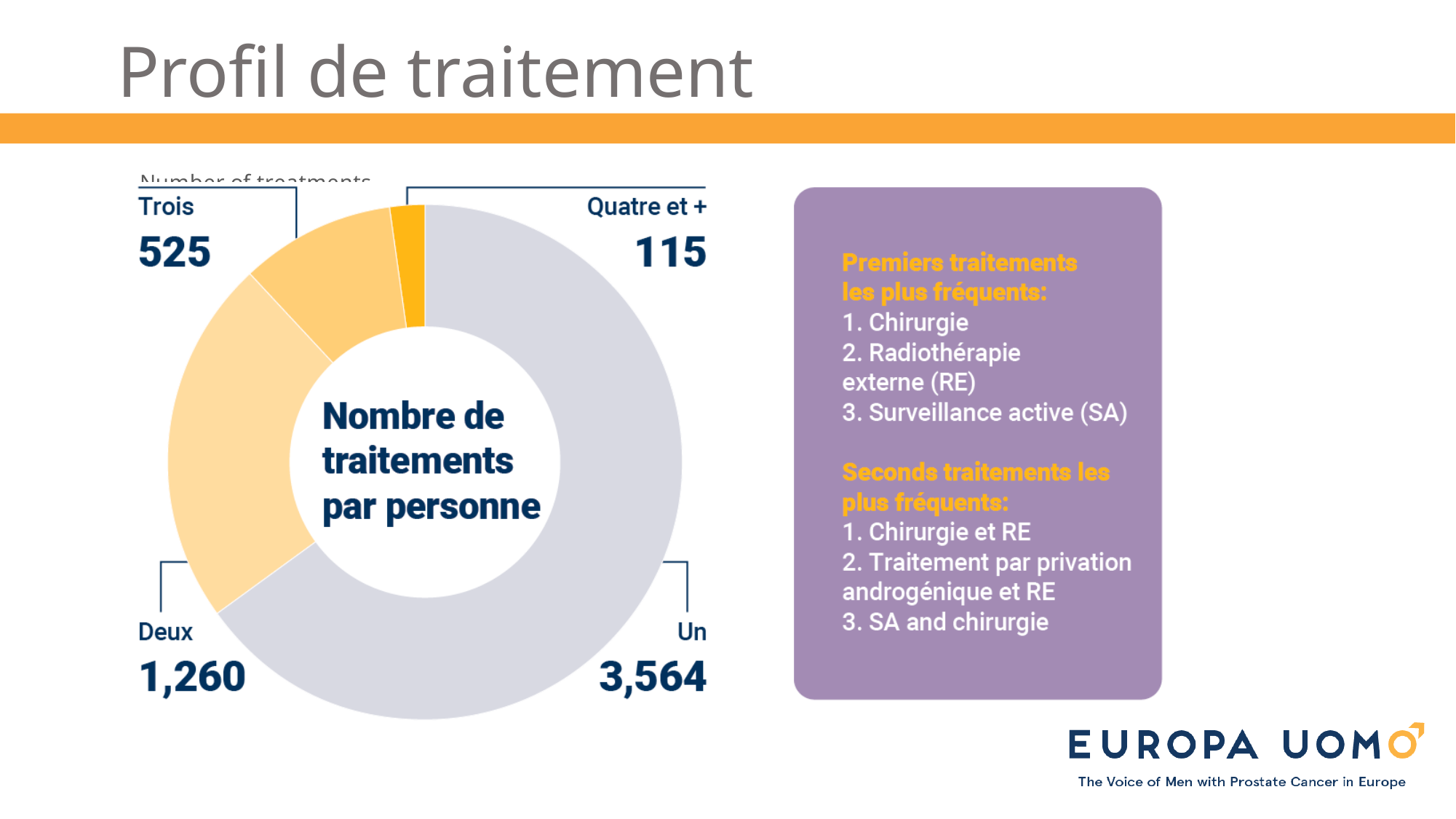
What is the total of all four segments in the chart? 5,464 Which is larger, the value for 'Deux' or the value for 'Trois'? Deux Which category has the smallest value in the chart? Quatre et + Which category has the largest value in the chart? Un How many categories does the donut chart show? 4 What is the value shown for the 'Deux' segment of the chart? 1,260 How many people had one treatment (Un) according to the donut chart? 3,564 What is the difference between the values for 'Trois' and 'Quatre et +'? 410 What is the difference between the values for 'Un' and 'Deux'? 2,304 What is the value for the 'Quatre et +' segment? 115 What value is shown for 'Trois' in the chart? 525 What type of chart is used to show the number of treatments per person? Donut (pie) chart